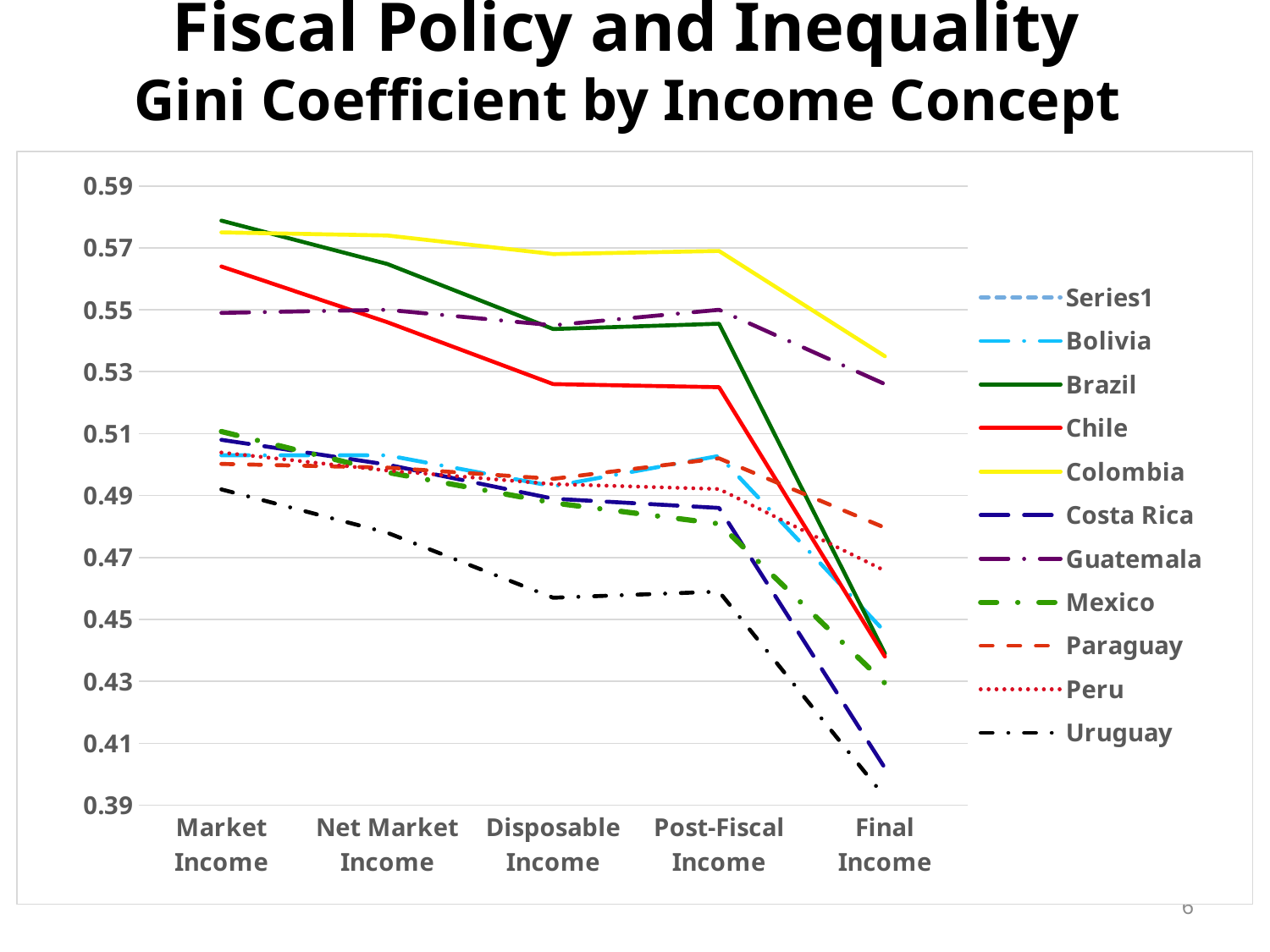
Which country has the lowest Gini coefficient at Market Income? Uruguay How many series does the legend list? 11 Which country has the highest Gini coefficient at Final Income? Colombia Is the value for Uruguay at Final Income greater or less than 0.41? less How many income concepts are shown along the x axis? 5 At Final Income, which is larger: the value for Guatemala or the value for Chile? Guatemala Is the value for Chile at Market Income greater or less than 0.55? greater What kind of chart is shown on the slide? line chart Which country has the lowest Gini coefficient at Final Income? Uruguay What colour is the Colombia line? yellow Is the value for Colombia at Post-Fiscal Income greater or less than 0.55? greater Does the Uruguay line rise or fall from Market Income to Final Income? fall